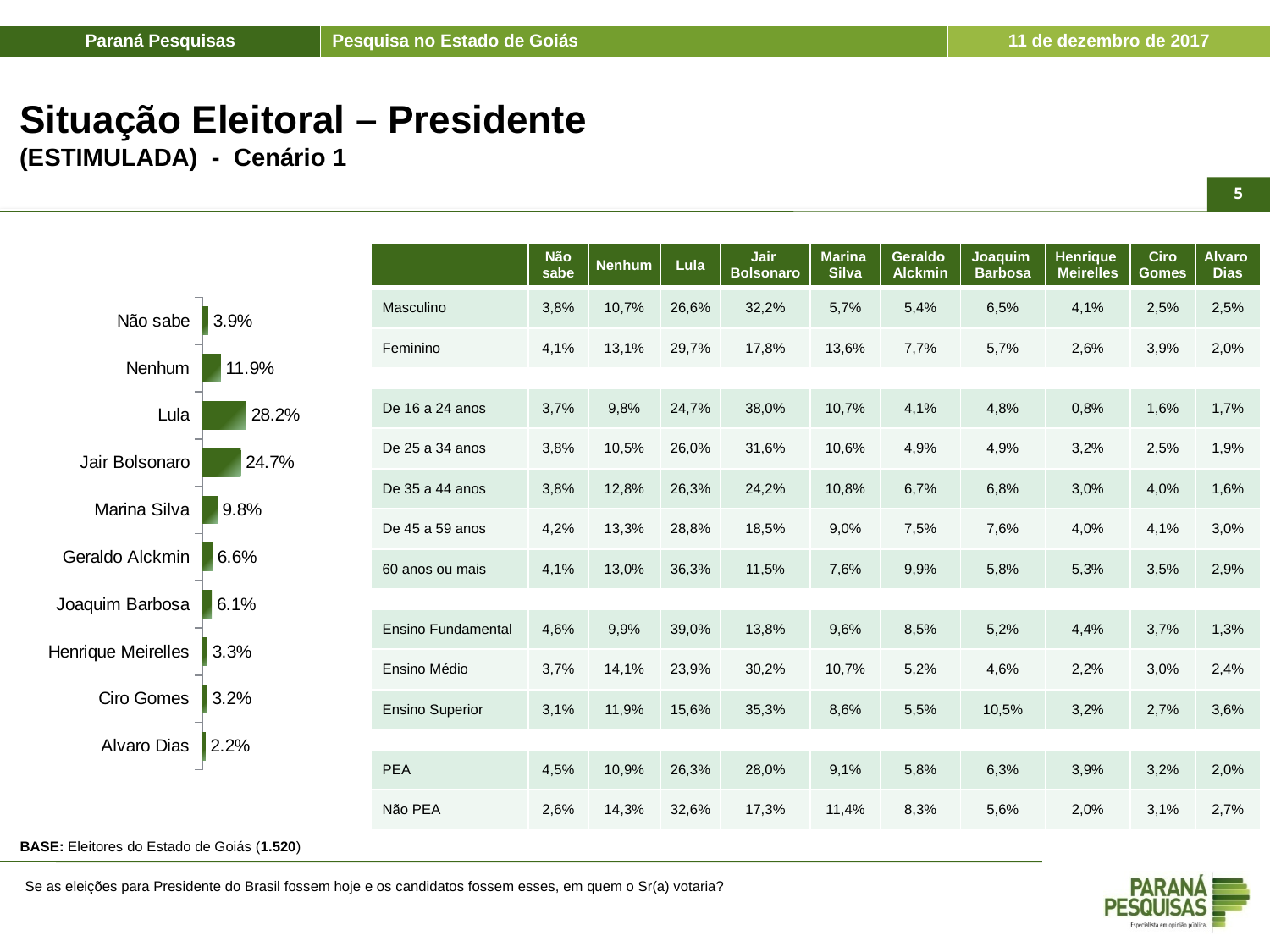
What kind of chart is shown on the left of the slide? Bar chart What value does the bar chart show for Marina Silva? 9.8% Which category has the lowest value in the bar chart? Alvaro Dias What value does the bar chart show for Jair Bolsonaro? 24.7% What value does the bar chart show for Lula? 28.2% What is the value for Ciro Gomes in the bar chart? 3.2% How many categories are shown in the bar chart? 10 What is the difference between the values for Nenhum and Não sabe in the bar chart? 8.0% In the bar chart, which is larger: the value for Geraldo Alckmin or the value for Joaquim Barbosa? Geraldo Alckmin What is the difference between the values for Lula and Jair Bolsonaro in the bar chart? 3.5% What value does the bar chart show for Henrique Meirelles? 3.3% Which category has the highest value in the bar chart? Lula